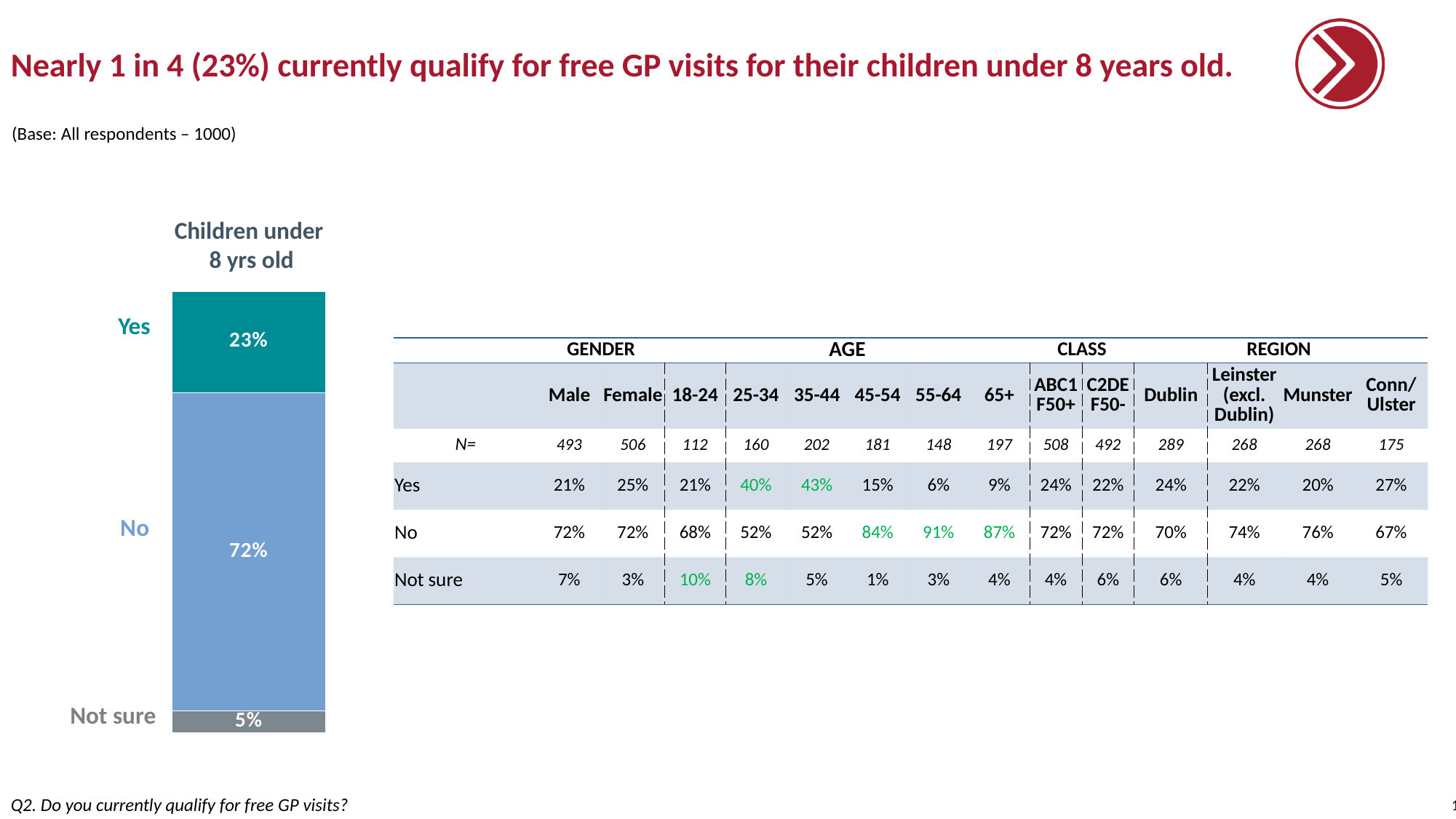
What percentage of the stacked bar is labelled "No"? 72% Which is larger in the stacked bar, "Yes" or "Not sure"? Yes What is the title above the stacked bar? Children under 8 yrs old Which segment of the stacked bar has the largest value? No What is the difference between the "Yes" and "Not sure" percentages in the stacked bar? 18 percentage points What is the difference between the "No" and "Yes" percentages in the stacked bar? 49 percentage points What percentage of the stacked bar is labelled "Not sure"? 5% Which segment of the stacked bar has the smallest value? Not sure How many segments make up the stacked bar? 3 What is the total of the three segments in the stacked bar? 100% What kind of chart is shown on the slide? Stacked bar chart What percentage of the stacked bar is labelled "Yes"? 23%